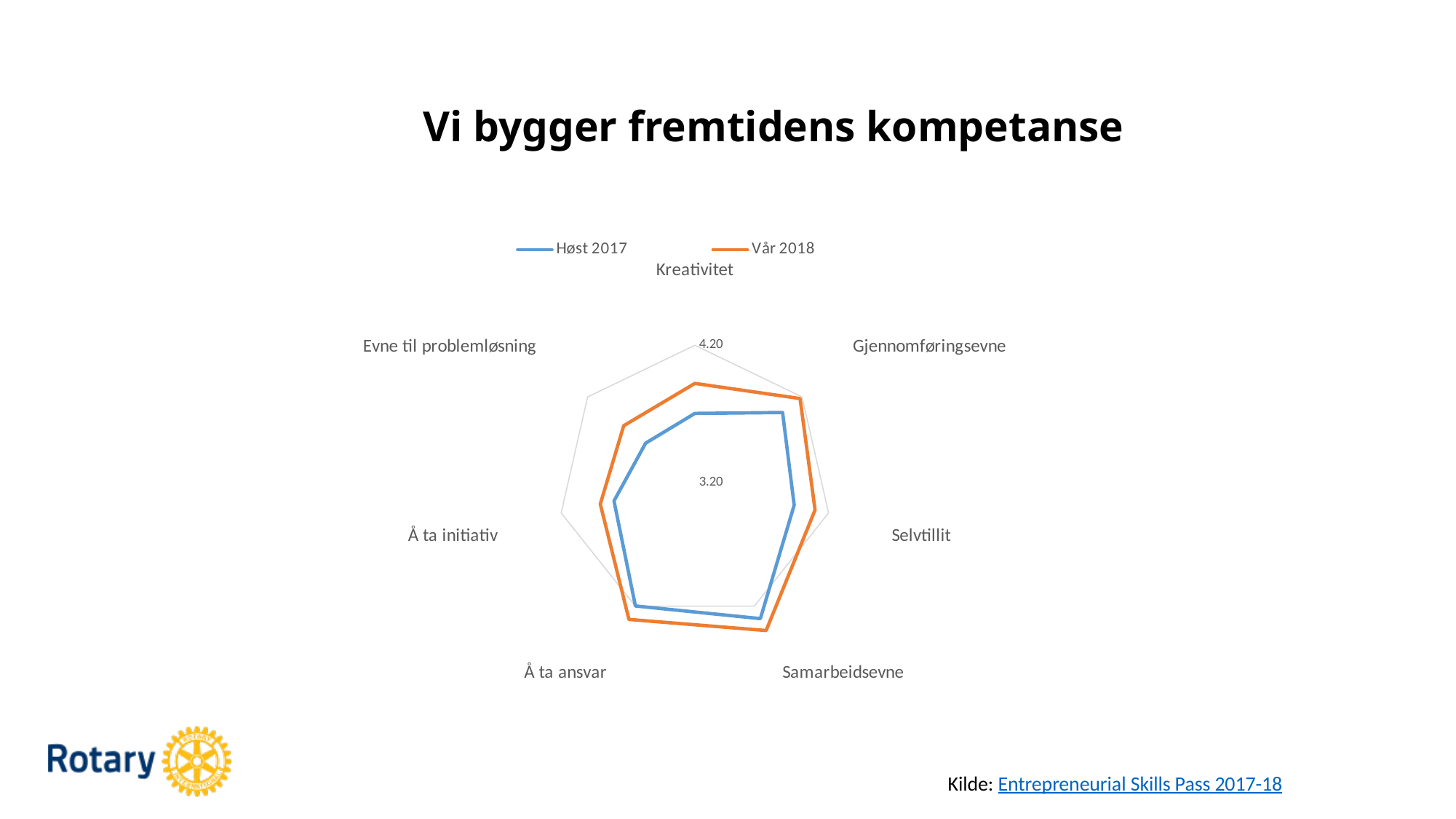
What kind of chart is shown on the slide? Radar chart Which series is drawn in orange? Vår 2018 Is the Høst 2017 value for Å ta ansvar greater or less than 3.20? greater How many series does the chart legend list? 2 Is the Vår 2018 value for Kreativitet greater or less than 4.20? less Which series has the higher value for Selvtillit, Høst 2017 or Vår 2018? Vår 2018 Is the Høst 2017 value for Gjennomføringsevne greater or less than 4.20? less What is the title of the slide containing the chart? Vi bygger fremtidens kompetanse Which series has the higher value for Kreativitet, Høst 2017 or Vår 2018? Vår 2018 How many categories (axes) does the radar chart have? 7 Which series has the higher value for Samarbeidsevne, Høst 2017 or Vår 2018? Vår 2018